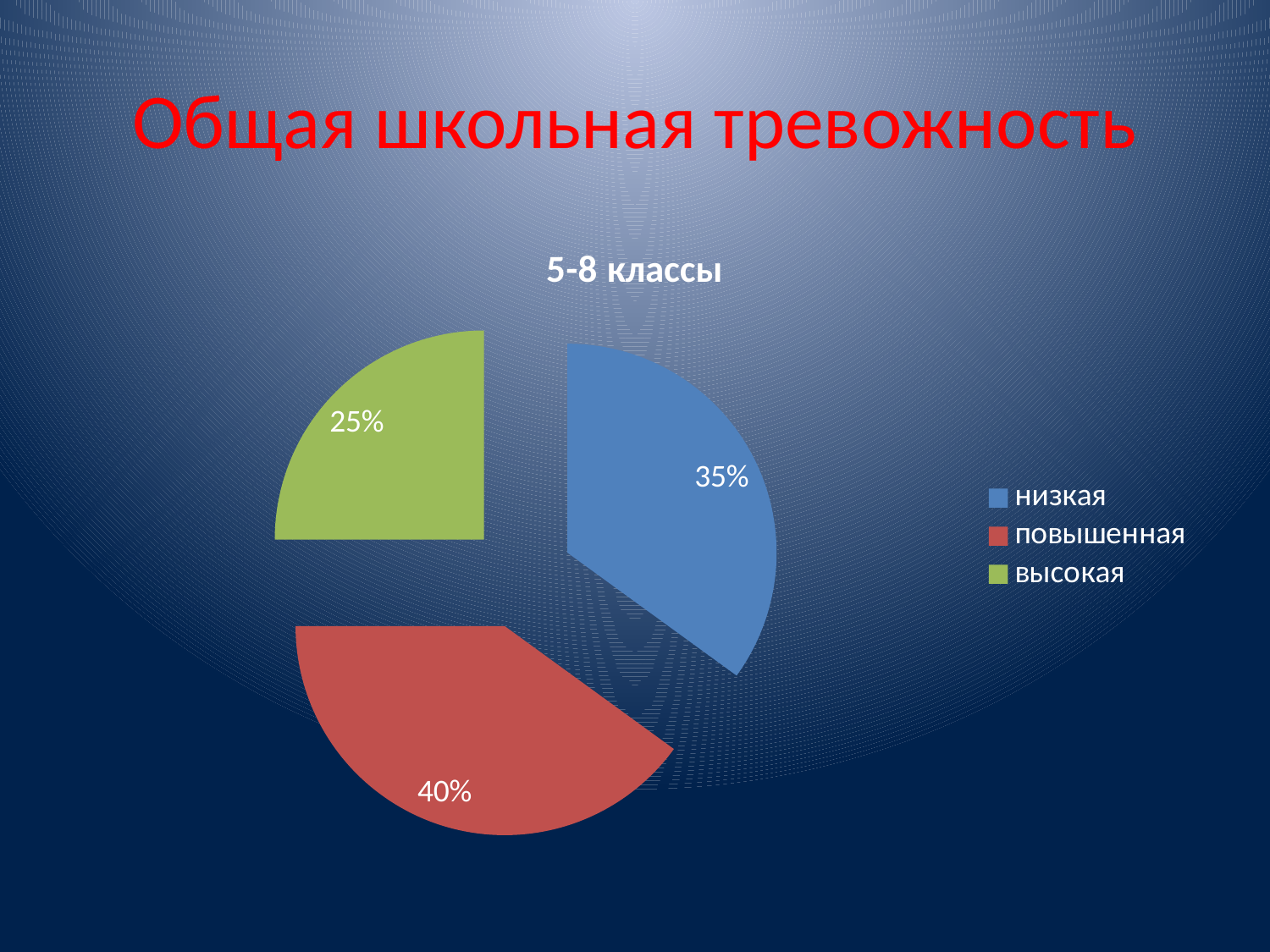
What is the value shown for 'повышенная'? 40% What is the title of the chart? 5-8 классы Which is larger, 'низкая' or 'высокая'? низкая What share of the pie does the 'низкая' slice represent? 35% What is the difference between the 'низкая' and 'высокая' values? 10% What kind of chart is shown on the slide? pie chart Which category has the smallest slice of the pie? высокая How many slices does the pie chart have? 3 What is the value shown for 'высокая'? 25% Which colour represents 'высокая' in the legend? green What is the difference between the 'повышенная' and 'низкая' values? 5% Which category has the largest slice of the pie? повышенная